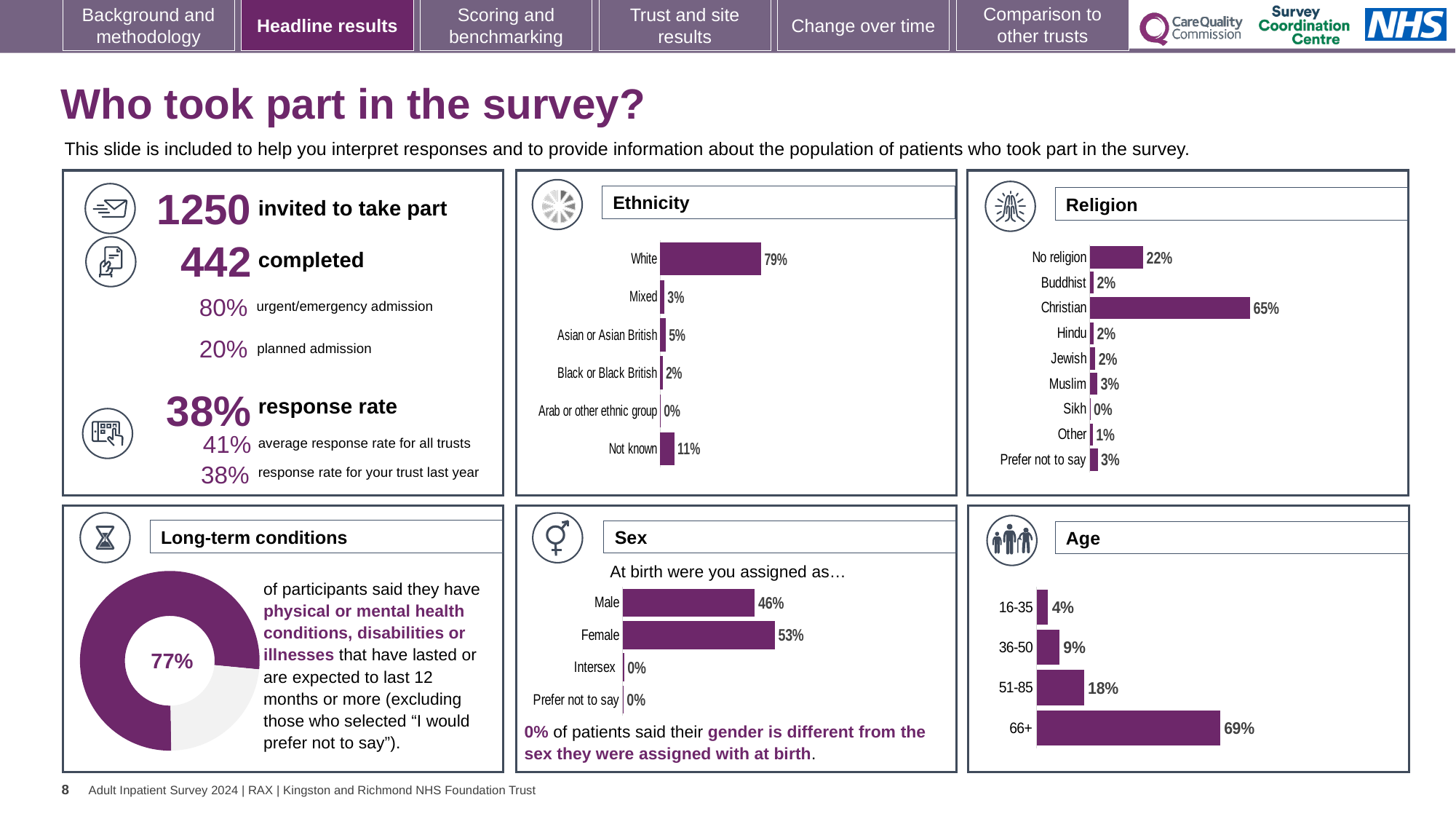
In the Age chart, what is the difference between the 66+ and 51-85 values? 51% In the Religion chart, what is the difference between the Christian and No religion values? 43% In the Religion chart, which category has the lowest value? Sikh In the Sex chart, what percentage of participants were Male? 46% In the Ethnicity chart, which category has the highest value? White In the Religion chart, what percentage of participants were Christian? 65% What kind of chart is the Long-term conditions chart? Doughnut chart In the Sex chart, which is larger, Male or Female? Female In the Ethnicity chart, what is the difference between the White and Not known values? 68% In the Ethnicity chart, what percentage of participants were White? 79% In the Age chart, what percentage of participants were aged 66+? 69% How many categories does the Religion chart show? 9